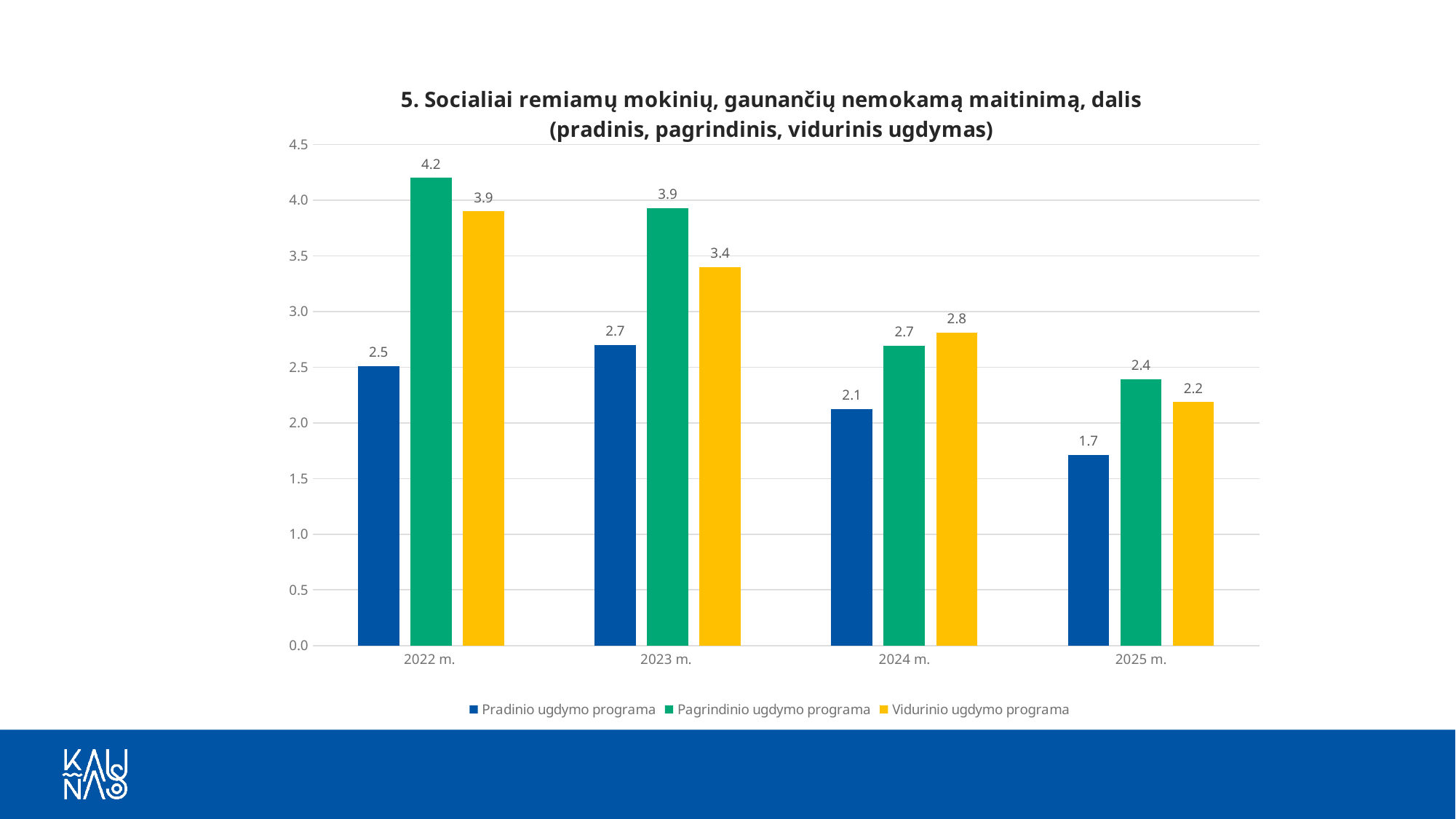
What is the value for Vidurinio ugdymo programa in 2025 m.? 2.2 Which year has the highest value for Pagrindinio ugdymo programa? 2022 m. Do the values for Pradinio ugdymo programa rise or fall from 2023 m. to 2025 m.? fall How many series does the legend list? 3 What is the value for Pagrindinio ugdymo programa in 2023 m.? 3.9 What is the difference between the Pagrindinio ugdymo programa and Pradinio ugdymo programa values in 2022 m.? 1.7 How many years are shown on the x axis? 4 Which year has the lowest value for Pradinio ugdymo programa? 2025 m. What kind of chart is shown on the slide? bar chart Which is larger in 2024 m.: Pagrindinio ugdymo programa or Vidurinio ugdymo programa? Vidurinio ugdymo programa Is the value for Pradinio ugdymo programa in 2023 m. greater or less than 3.0? less What is the value for Pradinio ugdymo programa in 2022 m.? 2.5